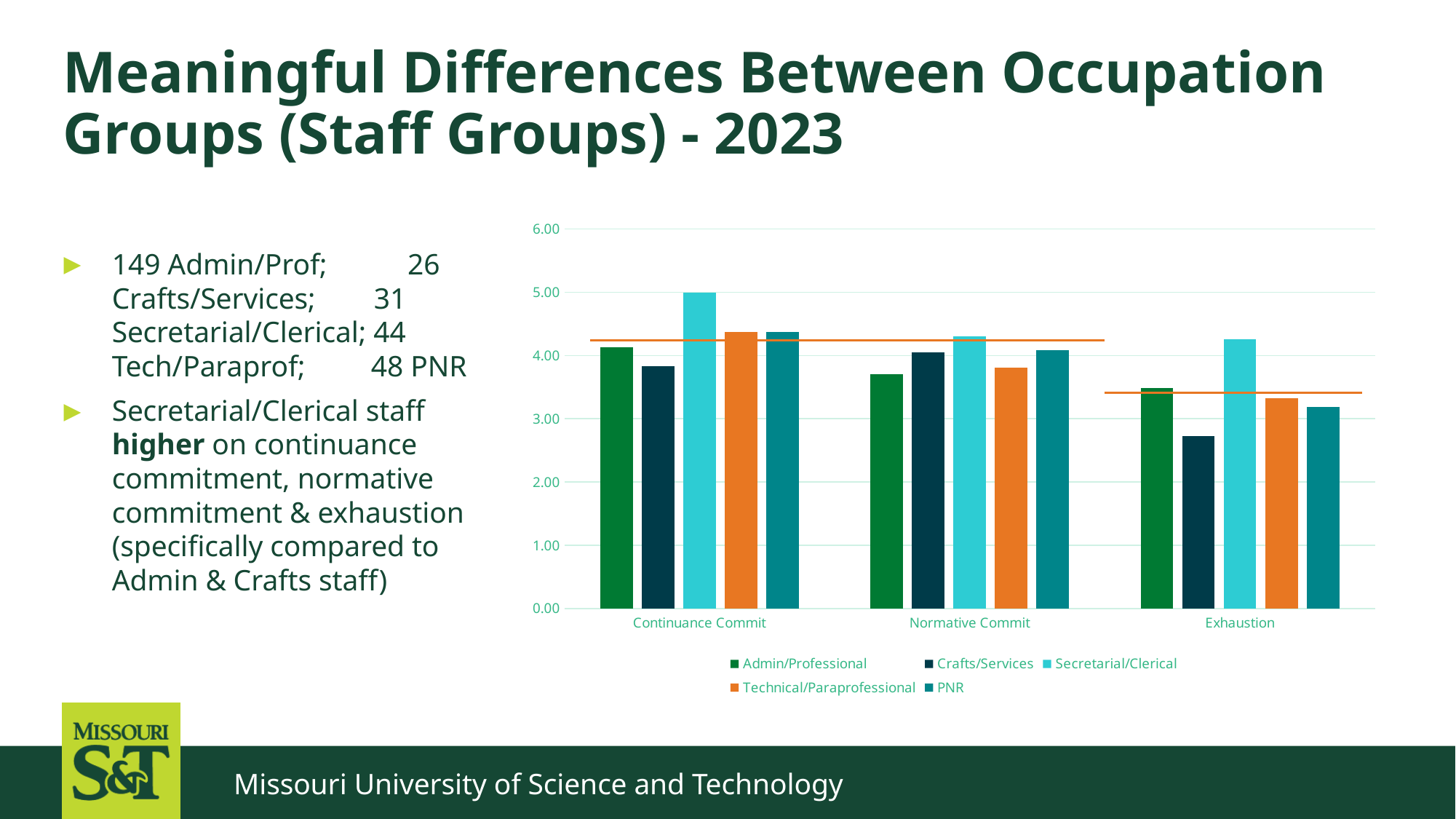
How many categories are shown on the x axis of the chart? 3 Which occupation group has the highest value for Continuance Commit? Secretarial/Clerical Do the Admin/Professional values rise or fall from Continuance Commit to Exhaustion? fall Is the value for Technical/Paraprofessional on Normative Commit greater or less than 4.00? less Is the value for Crafts/Services on Exhaustion greater or less than 3.00? less Which occupation group has the highest value for Exhaustion? Secretarial/Clerical For Normative Commit, which is larger: Admin/Professional or Crafts/Services? Crafts/Services Is the value for Secretarial/Clerical on Continuance Commit greater or less than 4.00? greater How many series does the chart legend list? 5 What kind of chart is shown on the slide? bar chart Which occupation group has the lowest value for Continuance Commit? Crafts/Services Which occupation group has the lowest value for Exhaustion? Crafts/Services